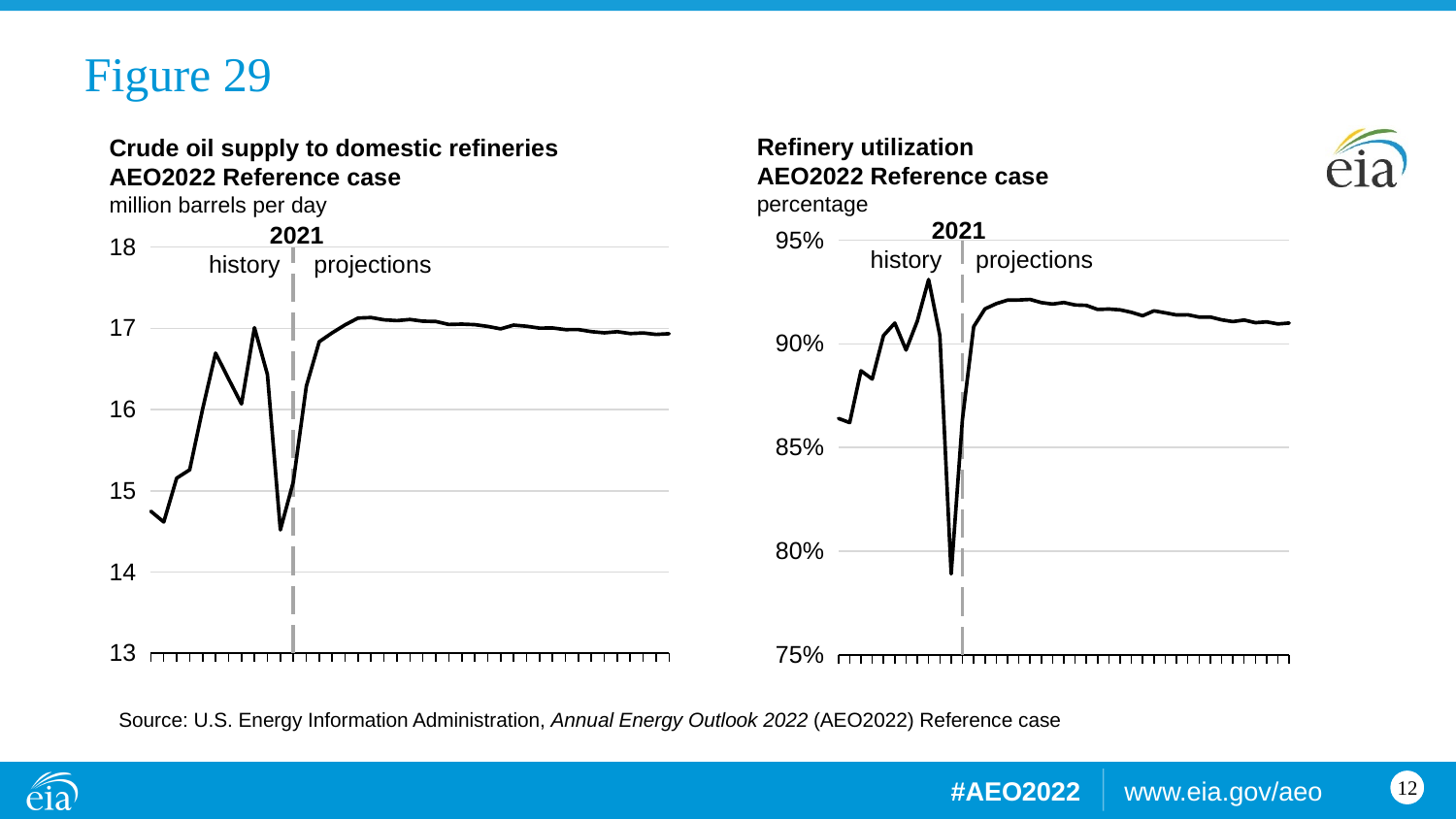
In the 'Crude oil supply to domestic refineries' chart, are the values during the projection period greater or less than 16? greater In the 'Refinery utilization' chart, is the lowest value of the line (the dip just before 2021) greater or less than 80%? less In the 'Crude oil supply to domestic refineries' chart, is the lowest value of the line (the dip just before 2021) greater or less than 15? less How many data series are plotted in the 'Crude oil supply to domestic refineries' chart? 1 In the 'Refinery utilization' chart, what year does the dashed vertical line separating history from projections mark? 2021 What kind of chart is the 'Crude oil supply to domestic refineries' chart? line chart In the 'Refinery utilization' chart, does the line rise or fall immediately after the 2021 marker? rise In the 'Crude oil supply to domestic refineries' chart, what unit is the y axis measured in? million barrels per day What kind of chart is the 'Refinery utilization' chart? line chart